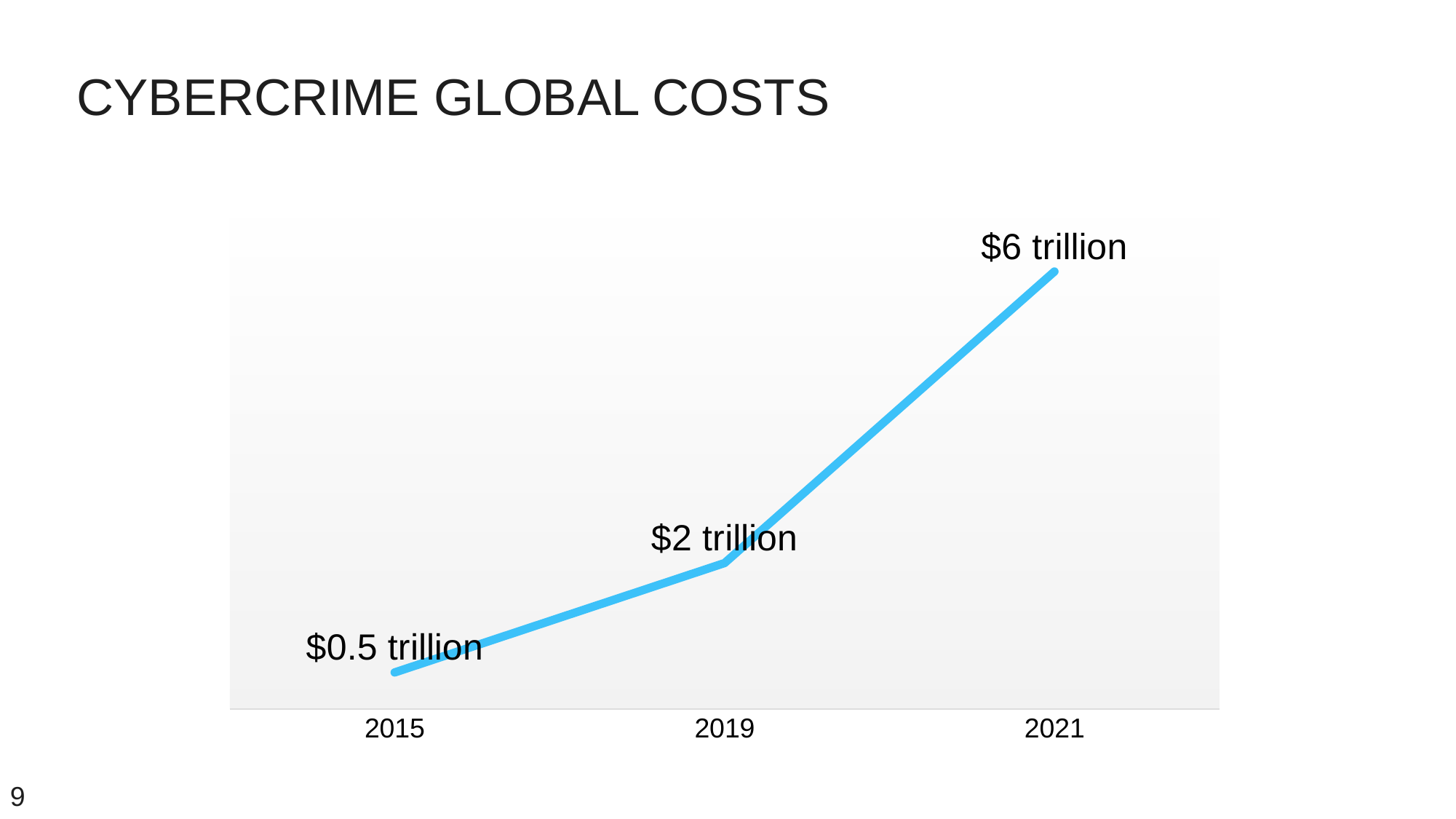
What is the cybercrime global cost shown for 2021? $6 trillion Which year has the highest cybercrime global cost? 2021 What is the difference between the cost in 2021 and the cost in 2019? $4 trillion Do the cybercrime global costs rise or fall from 2015 to 2021? Rise What kind of chart is shown on the slide? Line chart What is the cybercrime global cost shown for 2015? $0.5 trillion What is the difference between the cost in 2019 and the cost in 2015? $1.5 trillion How many years are plotted on the chart? 3 What is the cybercrime global cost shown for 2019? $2 trillion What is the title of the slide containing the chart? CYBERCRIME GLOBAL COSTS Which year has the lowest cybercrime global cost? 2015 Which year has the larger cybercrime global cost, 2015 or 2019? 2019